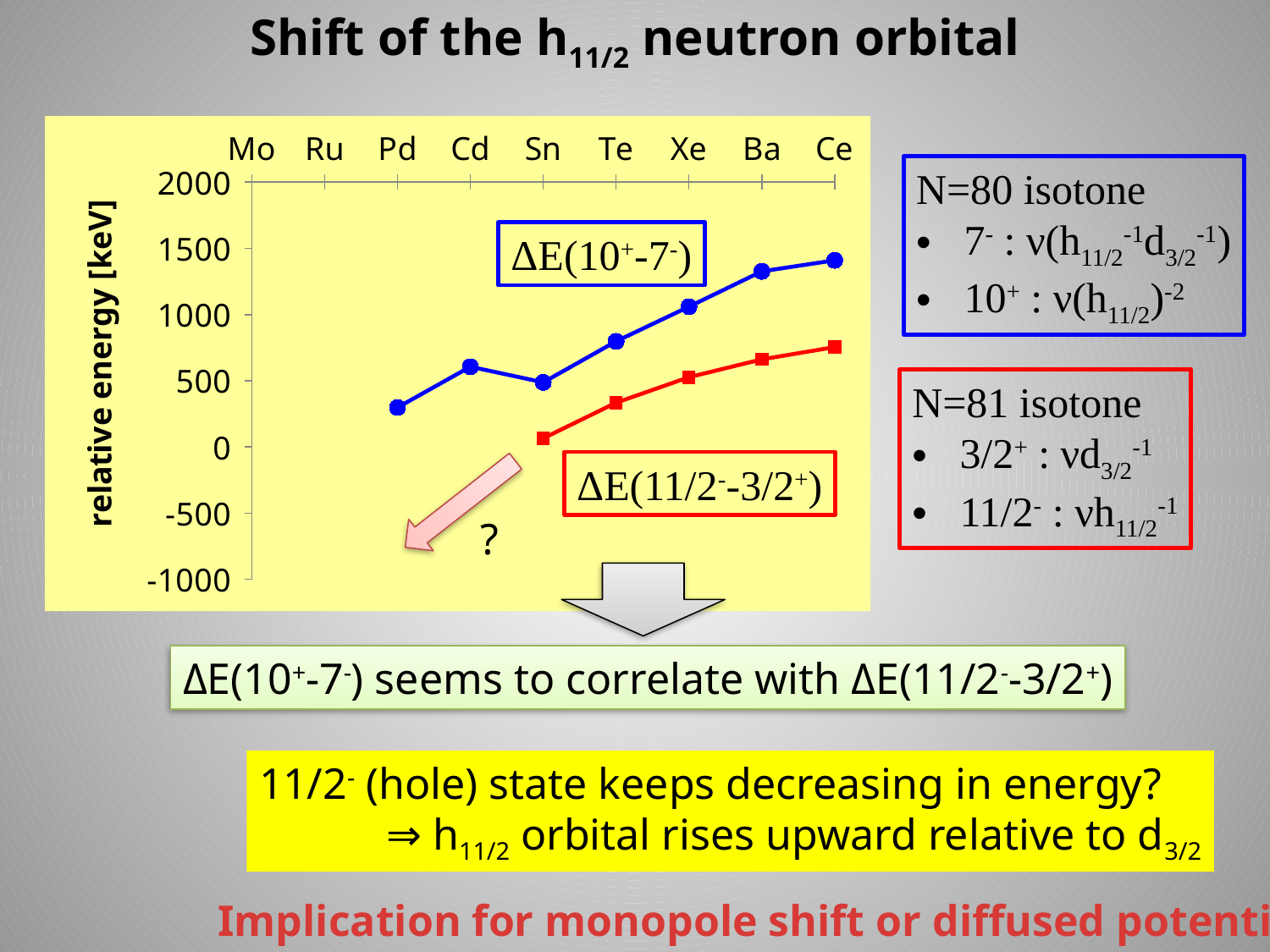
Is the ΔE(11/2⁻-3/2⁺) value at Sn greater or less than 500? less What kind of chart is shown on the slide? line chart What is the label of the y axis of the chart? relative energy [keV] At which element does the ΔE(10⁺-7⁻) series reach its highest value? Ce At Sn, which series has the larger value, ΔE(10⁺-7⁻) or ΔE(11/2⁻-3/2⁺)? ΔE(10⁺-7⁻) Does the ΔE(11/2⁻-3/2⁺) series rise or fall from Sn to Ce? rise How many element labels are shown along the x axis of the chart? 9 Is the ΔE(10⁺-7⁻) value at Ce greater or less than 1000? greater How many data series are plotted in the chart? 2 At which element does the ΔE(11/2⁻-3/2⁺) series have its lowest value? Sn Which series is drawn in red in the chart? ΔE(11/2⁻-3/2⁺) At which element does the ΔE(10⁺-7⁻) series have its lowest value? Pd